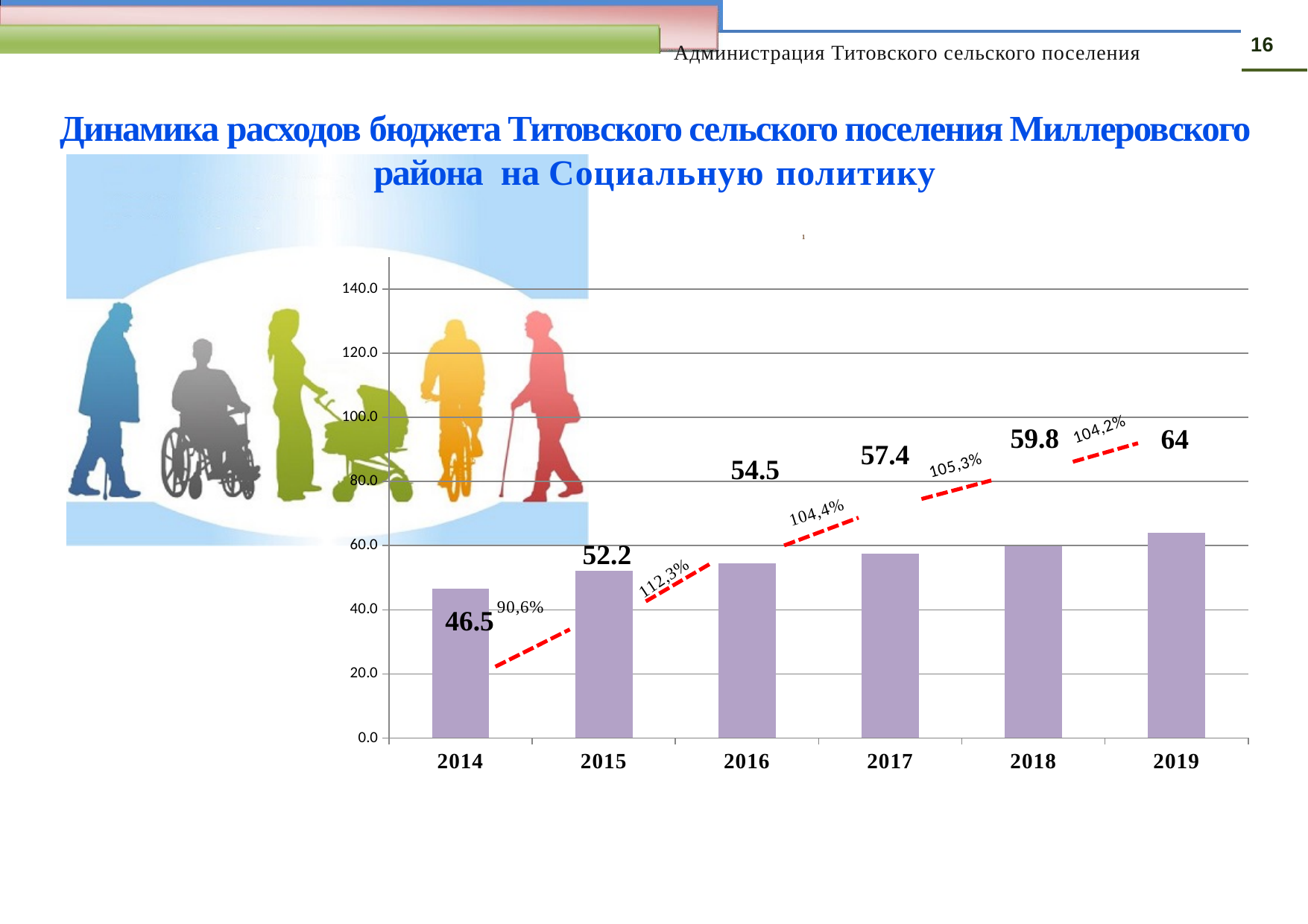
What is the difference between the values for 2019 and 2014? 17.5 Do the values rise or fall from 2014 to 2019? rise What is the value for 2014? 46.5 How many years are shown on the x axis? 6 Which year has the highest value? 2019 Is the value for 2019 greater or less than 60.0? greater Which year has the lowest value? 2014 What is the value for 2017? 57.4 What kind of chart is shown on the slide? bar chart Which is larger, the value for 2018 or the value for 2016? 2018 What is the difference between the values for 2016 and 2015? 2.3 What is the value for 2019? 64